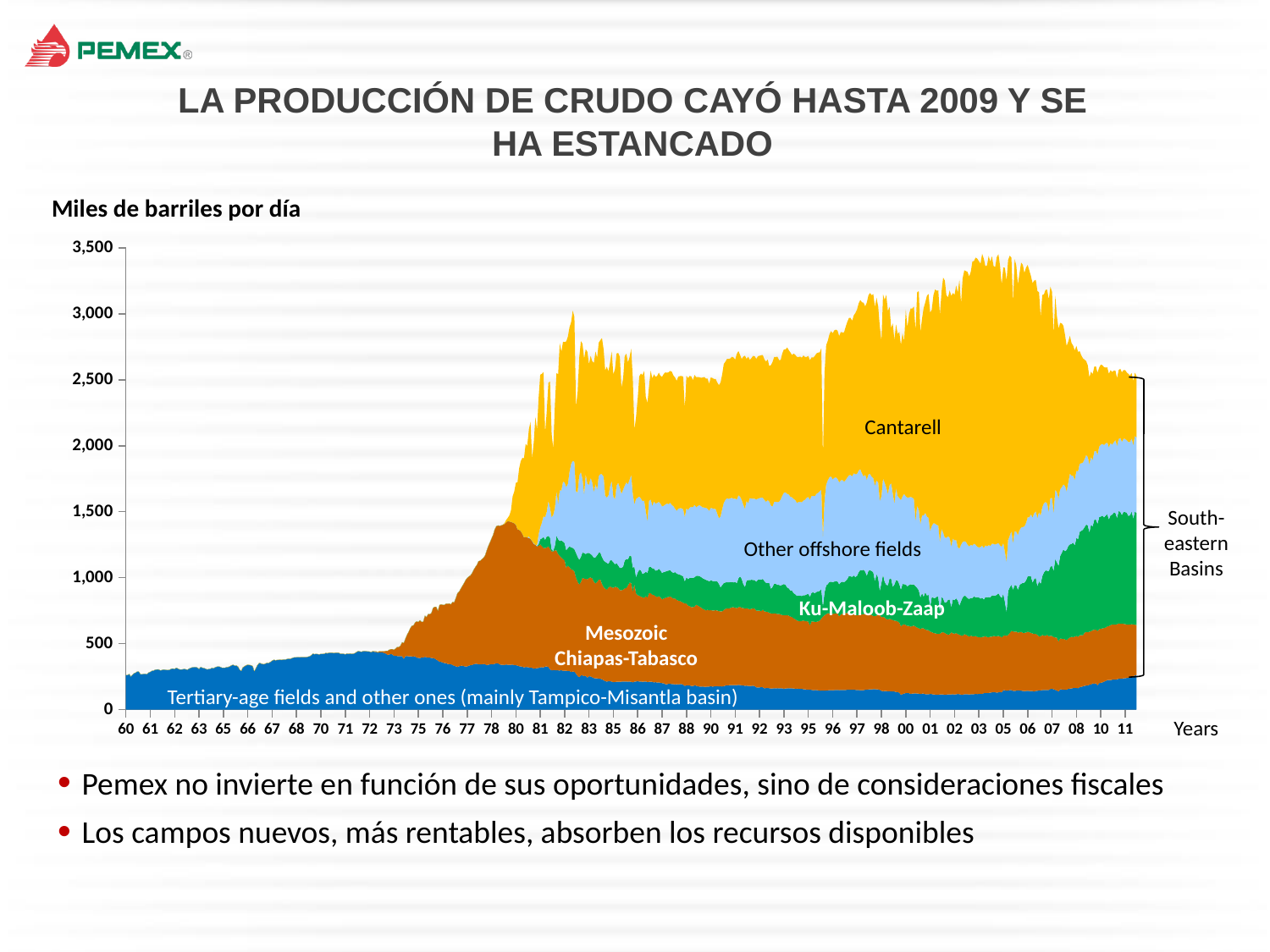
Is the total crude production in 1968 greater or less than 500 thousand barrels per day? less Which field group is plotted as the top (yellow) layer of the stacked area chart? Cantarell Does total crude production rise or fall between 2004 and 2009? fall What kind of chart is shown on the slide? Stacked area chart Is the total crude production in 2011 greater or less than 3,000 thousand barrels per day? less What is the unit label shown above the chart's y axis? Miles de barriles por día Is the peak total crude production around 2003–2004 greater or less than 3,000 thousand barrels per day? greater How many production series (field groups) are labelled in the chart? 5 Does total crude production rise or fall between 1960 and 1980? rise